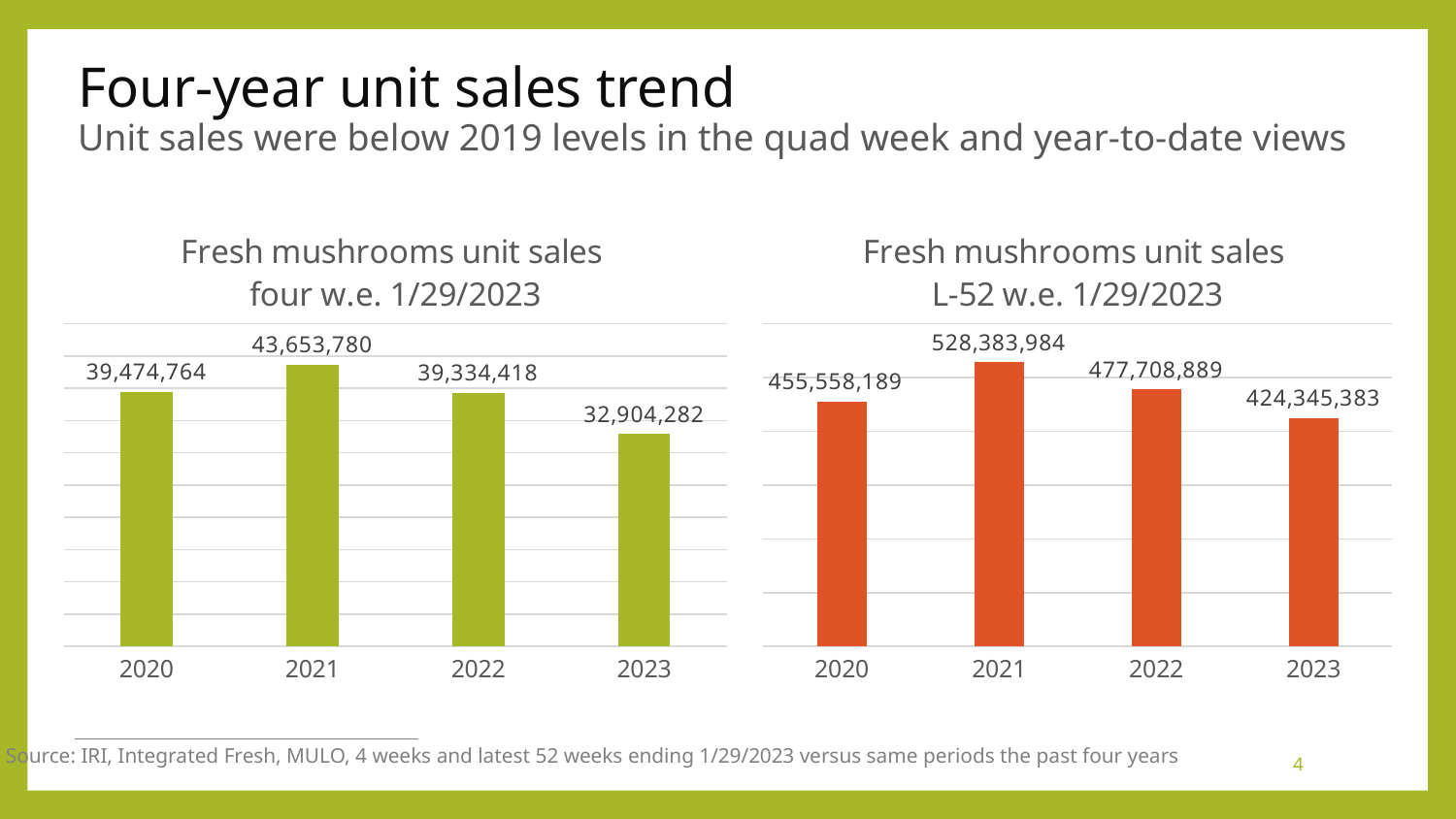
What kind of chart is the 'Fresh mushrooms unit sales L-52 w.e. 1/29/2023' chart? Bar chart In the 'Fresh mushrooms unit sales L-52 w.e. 1/29/2023' chart, which year has the lowest value? 2023 In the 'Fresh mushrooms unit sales L-52 w.e. 1/29/2023' chart, which is larger, the value for 2022 or the value for 2023? 2022 In the 'Fresh mushrooms unit sales four w.e. 1/29/2023' chart, what is the value for 2023? 32,904,282 In the 'Fresh mushrooms unit sales four w.e. 1/29/2023' chart, do the values rise or fall from 2021 to 2023? Fall In the 'Fresh mushrooms unit sales L-52 w.e. 1/29/2023' chart, what is the difference between the 2021 and 2020 values? 72,825,795 In the 'Fresh mushrooms unit sales L-52 w.e. 1/29/2023' chart, what is the value for 2020? 455,558,189 In the 'Fresh mushrooms unit sales four w.e. 1/29/2023' chart, which year has the highest value? 2021 In the 'Fresh mushrooms unit sales L-52 w.e. 1/29/2023' chart, what is the value for 2022? 477,708,889 How many years are shown on the x axis of the 'Fresh mushrooms unit sales four w.e. 1/29/2023' chart? 4 In the 'Fresh mushrooms unit sales four w.e. 1/29/2023' chart, what is the value for 2021? 43,653,780 In the 'Fresh mushrooms unit sales four w.e. 1/29/2023' chart, what is the difference between the 2021 and 2023 values? 10,749,498